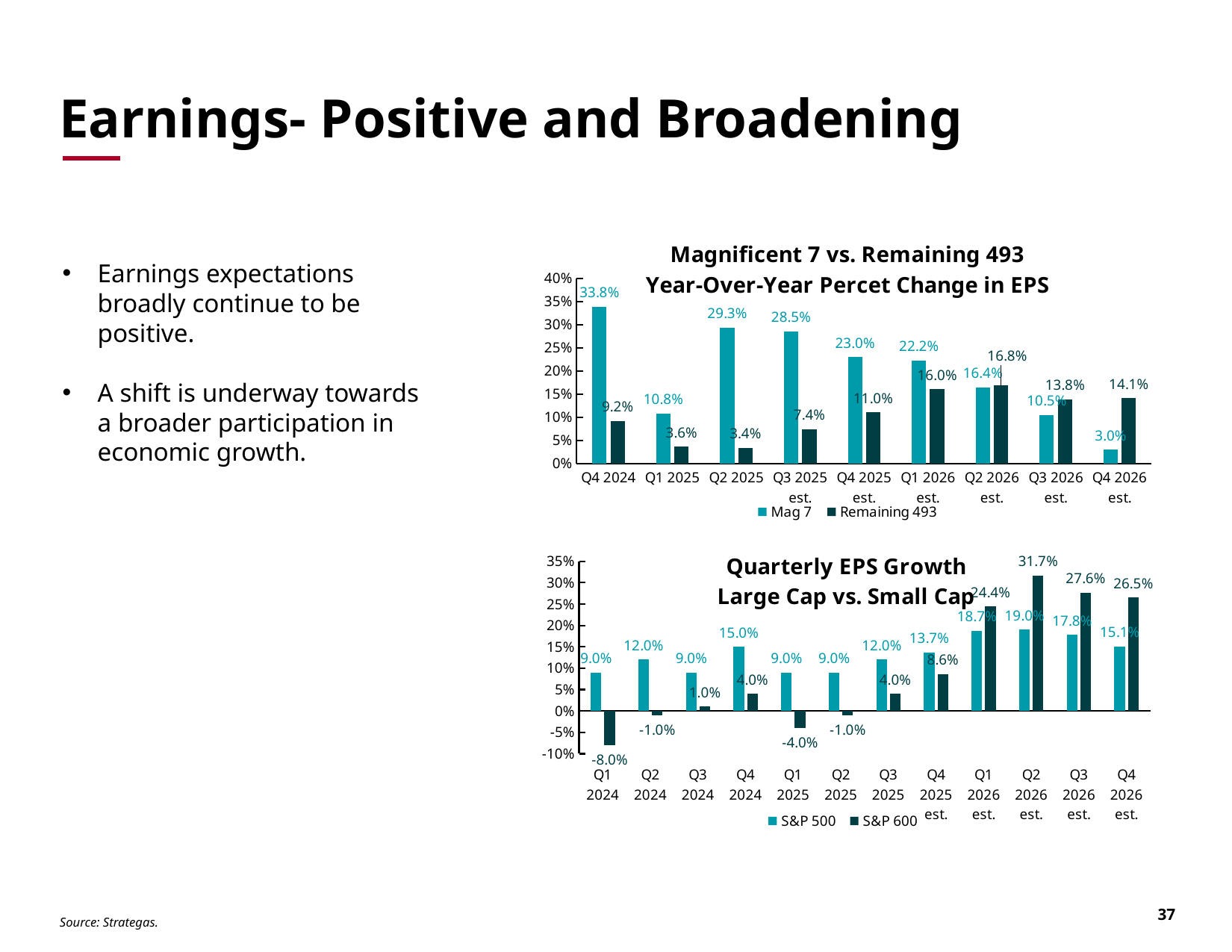
In the 'Magnificent 7 vs. Remaining 493' chart, how many quarters are shown on the x axis? 9 In the 'Quarterly EPS Growth Large Cap vs. Small Cap' chart, how many series does the legend list? 2 In the 'Magnificent 7 vs. Remaining 493' chart, what is the Mag 7 value for Q4 2024? 33.8% In the 'Quarterly EPS Growth Large Cap vs. Small Cap' chart, what is the difference between the S&P 600 and S&P 500 values for Q2 2026 est.? 12.7% In the 'Quarterly EPS Growth Large Cap vs. Small Cap' chart, which is larger for Q4 2025 est., S&P 500 or S&P 600? S&P 500 In the 'Magnificent 7 vs. Remaining 493' chart, which quarter has the lowest Mag 7 value? Q4 2026 est. What type of chart is the 'Quarterly EPS Growth Large Cap vs. Small Cap' chart? Bar chart In the 'Quarterly EPS Growth Large Cap vs. Small Cap' chart, what is the S&P 600 value for Q1 2024? -8.0% In the 'Magnificent 7 vs. Remaining 493' chart, which is larger for Q4 2026 est., Mag 7 or Remaining 493? Remaining 493 In the 'Magnificent 7 vs. Remaining 493' chart, what is the difference between the Mag 7 and Remaining 493 values for Q4 2024? 24.6% In the 'Magnificent 7 vs. Remaining 493' chart, what is the Remaining 493 value for Q2 2026 est.? 16.8% In the 'Quarterly EPS Growth Large Cap vs. Small Cap' chart, which quarter has the highest S&P 600 value? Q2 2026 est.